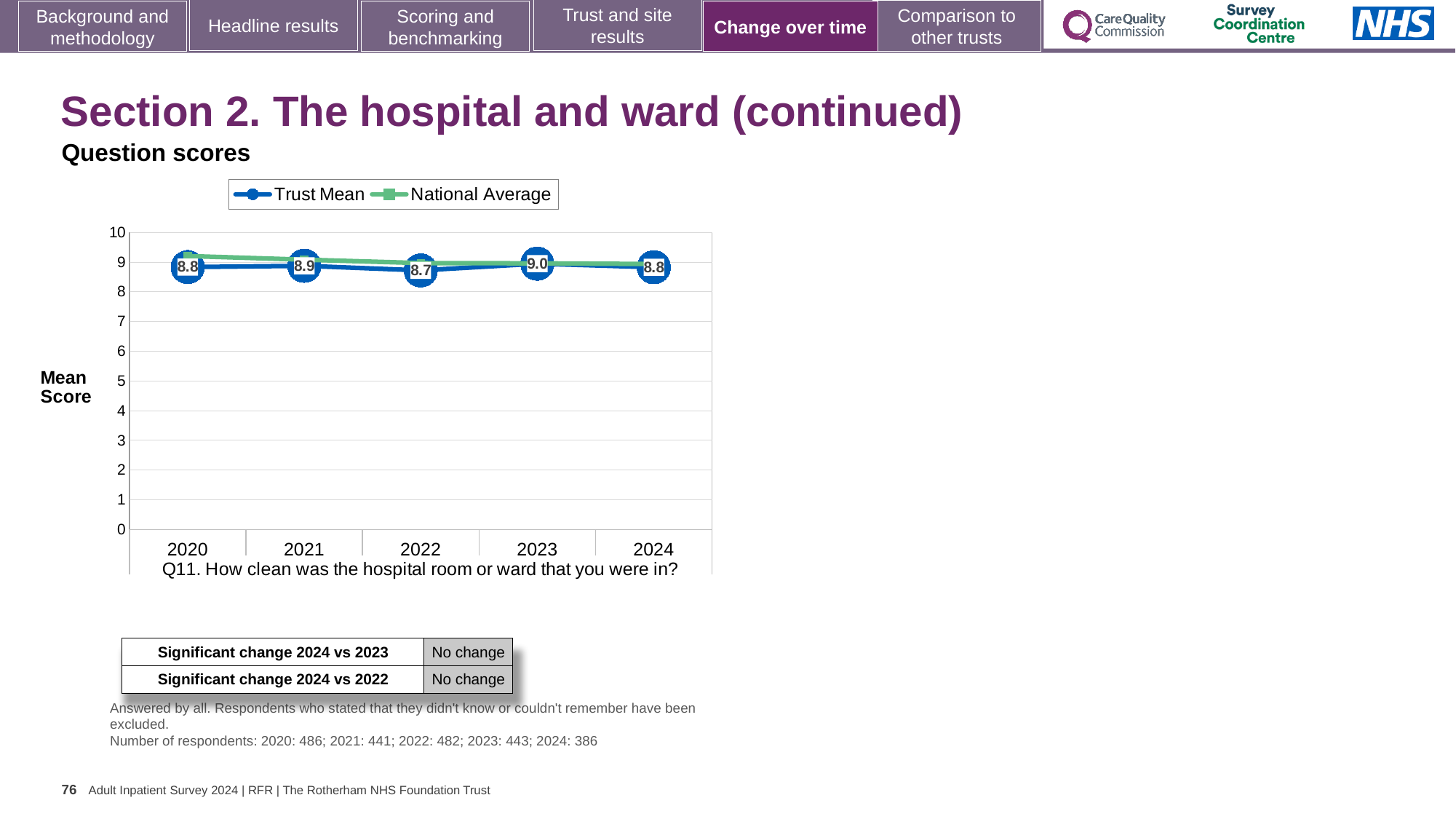
What is the Trust Mean value for 2022? 8.7 In which year is the Trust Mean highest? 2023 What is the Trust Mean value for 2020? 8.8 How many years are shown on the x axis of the chart? 5 How many series does the chart legend list? 2 Does the Trust Mean rise or fall from 2022 to 2023? rise What is the difference between the Trust Mean in 2023 and in 2022? 0.3 Is the National Average value for 2020 greater or less than 8? greater What is the Trust Mean value for 2023? 9.0 Which year has the larger Trust Mean, 2021 or 2022? 2021 In which year is the Trust Mean lowest? 2022 What kind of chart is shown on the slide? line chart